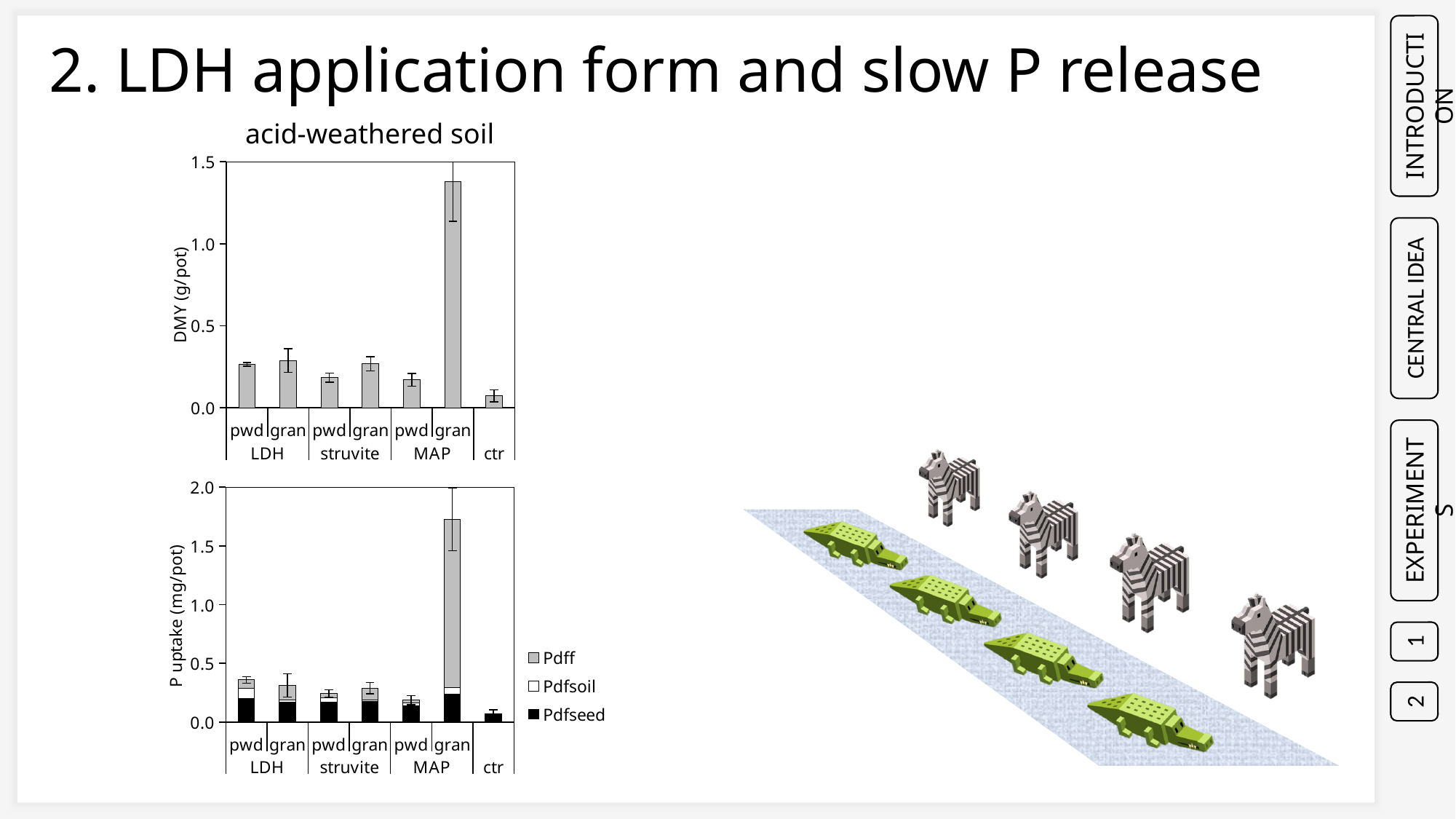
What type of chart is the top chart titled 'acid-weathered soil'? bar chart In the bottom chart (P uptake), how many series does the legend list? 3 In the bottom chart (P uptake), which legend entry is shown in black? Pdfseed In the top chart (DMY), how many bars are plotted? 7 In the bottom chart (P uptake), is the total for LDH gran greater or less than 0.5? less In the top chart (DMY), which bar is the lowest? ctr In the top chart (DMY), which bar is the highest? MAP gran In the bottom chart (P uptake), is the total for MAP gran greater or less than 1.5? greater In the top chart (DMY), is the value for MAP gran greater or less than 1.0? greater In the bottom chart (P uptake), which bar has the highest total? MAP gran In the top chart (DMY), which is larger: MAP gran or ctr? MAP gran